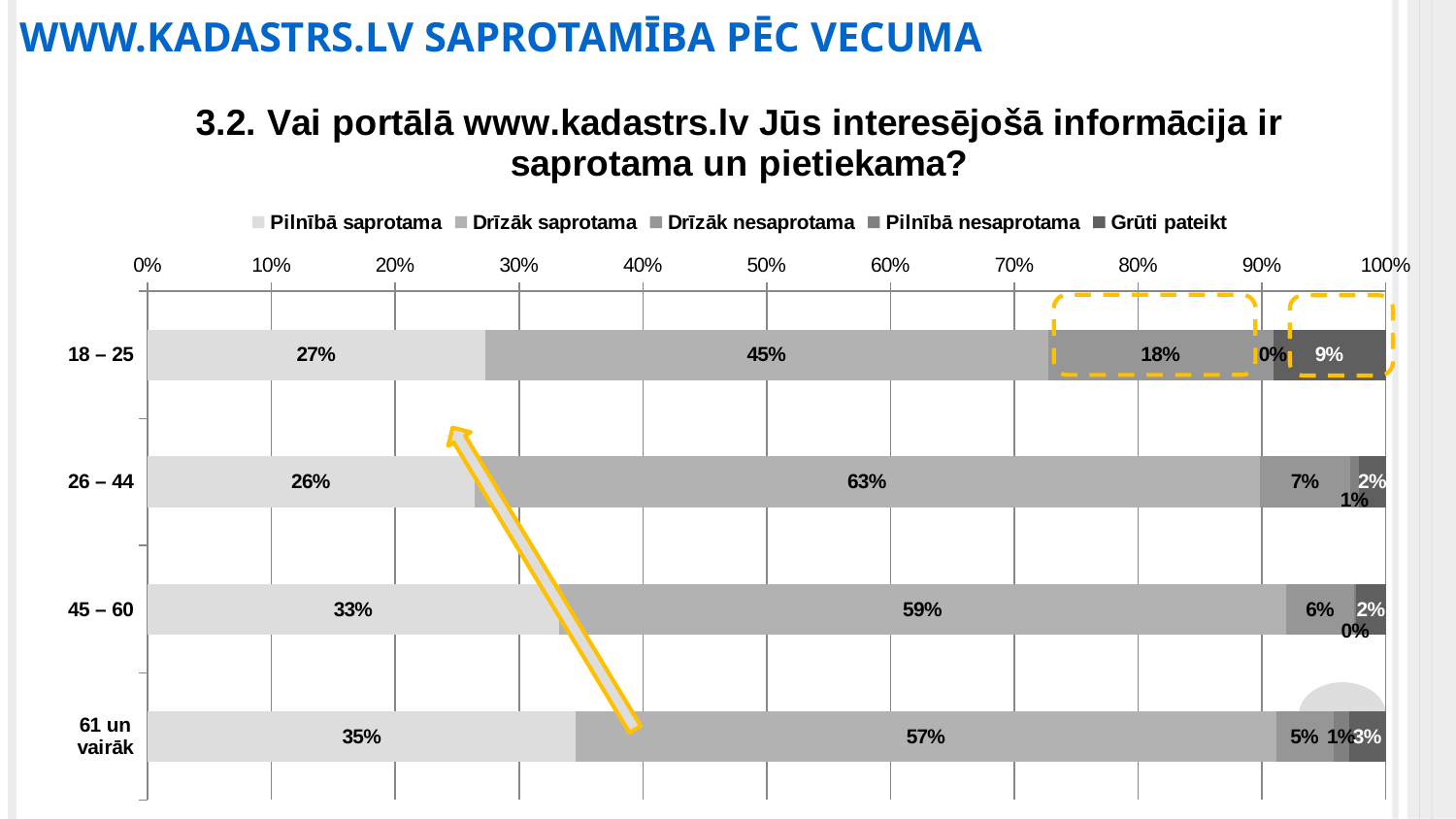
What is the difference between the 'Drīzāk saprotama' values for the 26 – 44 and 18 – 25 age groups? 18% Which age group has the highest value for 'Pilnībā saprotama'? 61 un vairāk How many age categories are plotted on the chart? 4 What is the value of 'Drīzāk nesaprotama' for the 18 – 25 age group? 18% Which series is listed first in the legend? Pilnībā saprotama Which age group has the lowest value for 'Drīzāk saprotama'? 18 – 25 What is the value of 'Grūti pateikt' for the 61 un vairāk age group? 3% What is the value of 'Drīzāk saprotama' for the 26 – 44 age group? 63% How many series does the legend list? 5 What kind of chart is shown on the slide? stacked bar chart What is the value of 'Pilnībā saprotama' for the 18 – 25 age group? 27% Which is larger: 'Pilnībā saprotama' for 45 – 60 or for 26 – 44? 45 – 60